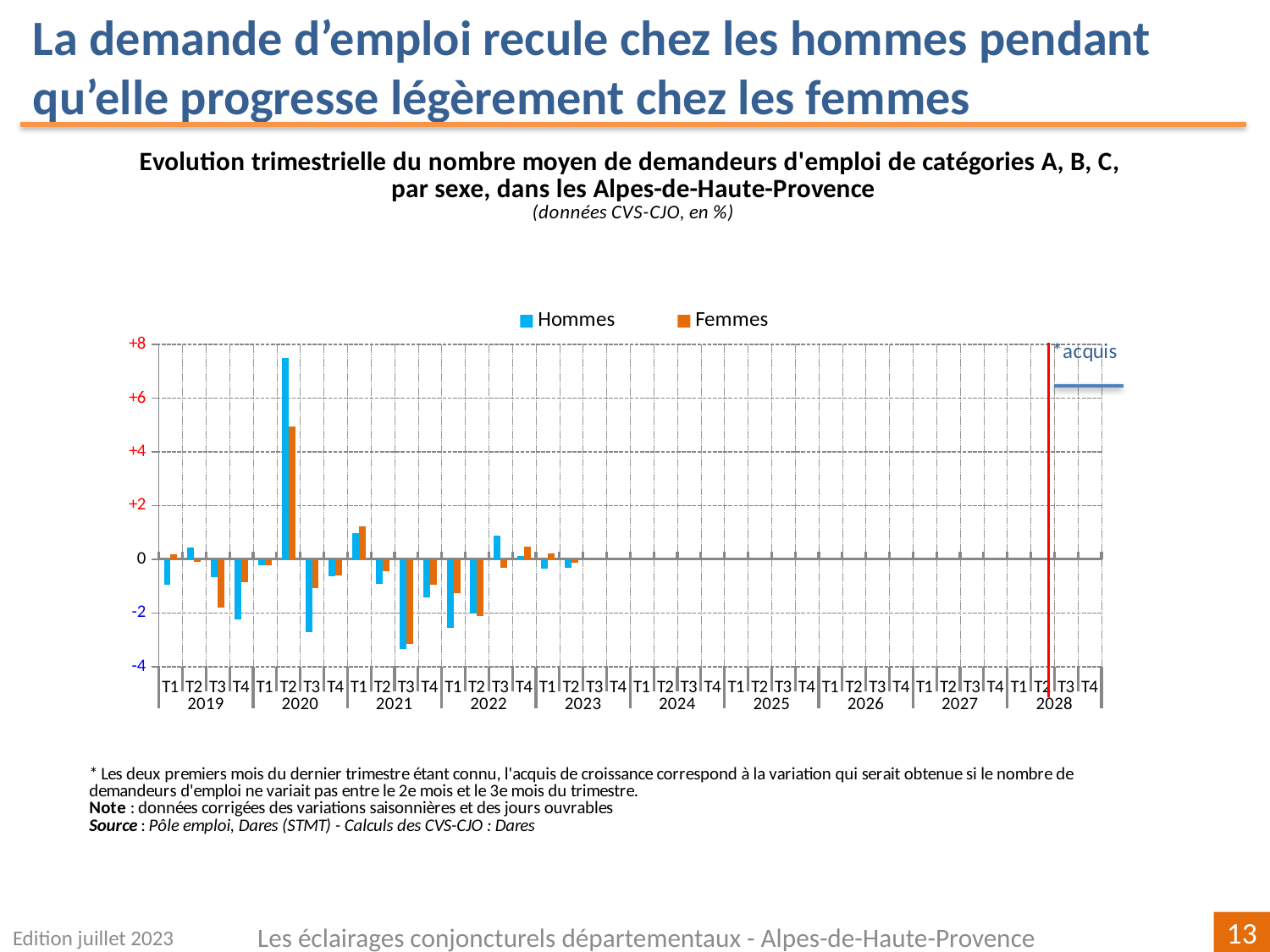
Is the Hommes value for T2 2020 greater or less than +6? greater In T2 2020, which series has the larger value, Hommes or Femmes? Hommes In which quarter does the Hommes series reach its highest value? T2 2020 What kind of chart is shown on the slide? bar chart In which quarter does the Femmes series reach its highest value? T2 2020 Is the Femmes value for T2 2020 greater or less than +4? greater What are the two series named in the legend? Hommes and Femmes How many series does the legend list? 2 In which quarter does the Hommes series reach its lowest value? T3 2021 Which colour represents the Femmes series? orange How many years are labelled along the x axis? 10 Is the Hommes value for T3 2021 greater or less than -2? less